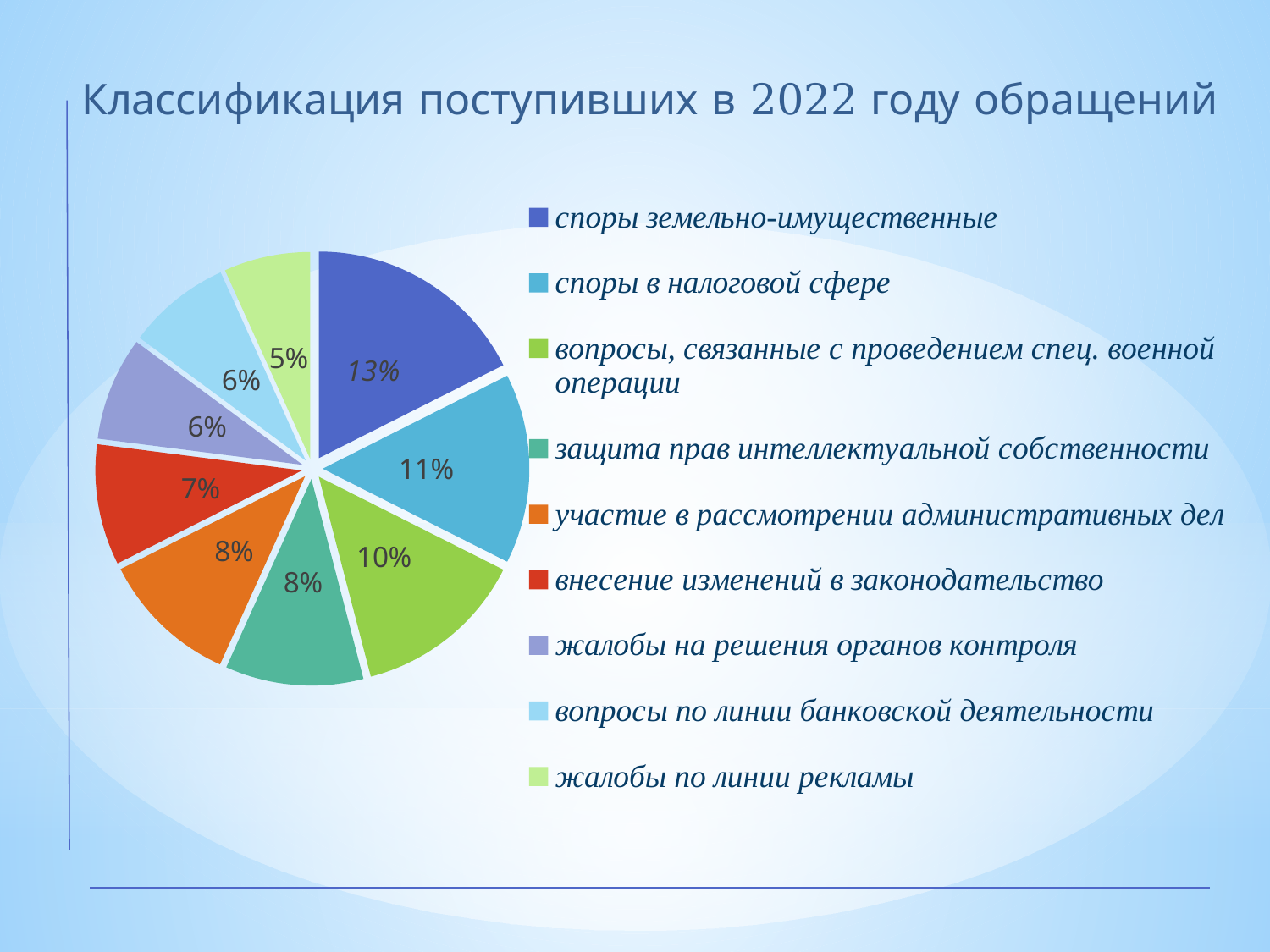
Which category has the largest slice of the pie? споры земельно-имущественные What is the title of the chart on the slide? Классификация поступивших в 2022 году обращений Which is larger: the slice for 'споры в налоговой сфере' or the slice for 'внесение изменений в законодательство'? споры в налоговой сфере What share of the pie is labelled for 'споры в налоговой сфере'? 11% How many categories does the pie chart have? 9 What share of the pie is labelled for 'жалобы по линии рекламы'? 5% Which category has the smallest slice of the pie? жалобы по линии рекламы What share of the pie is labelled for 'споры земельно-имущественные'? 13% What kind of chart is shown on the slide? pie chart What is the difference in percentage points between the largest slice (споры земельно-имущественные) and the smallest slice (жалобы по линии рекламы)? 8